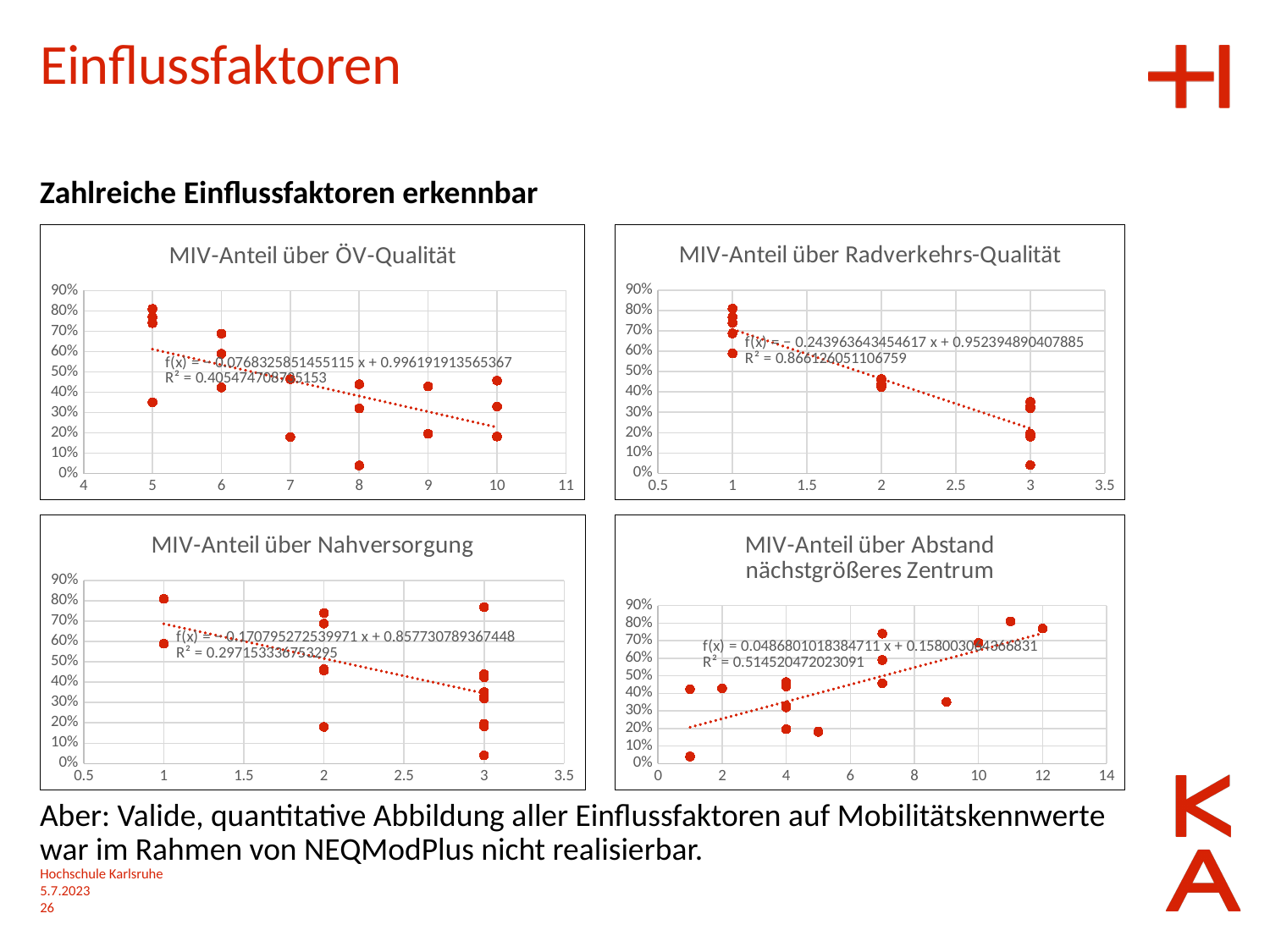
In the chart "MIV-Anteil über Radverkehrs-Qualität", what R² value is printed? 0.866126051106759 What kind of chart is "MIV-Anteil über ÖV-Qualität"? scatter chart In the chart "MIV-Anteil über Abstand nächstgrößeres Zentrum", does the dotted trendline rise or fall as the x value increases? rise In the chart "MIV-Anteil über Nahversorgung", does the dotted trendline rise or fall as the x value increases? fall What is the title of the top-left chart on the slide? MIV-Anteil über ÖV-Qualität In the chart "MIV-Anteil über ÖV-Qualität", does the dotted trendline rise or fall as the x value increases? fall In the chart "MIV-Anteil über Nahversorgung", is the higher of the two points at x = 1 greater or less than 70%? greater In the chart "MIV-Anteil über Radverkehrs-Qualität", are the points at x = 1 greater or less than 50%? greater How many charts are shown on the slide? 4 In the chart "MIV-Anteil über Radverkehrs-Qualität", is the lowest point at x = 3 greater or less than 10%? less In the chart "MIV-Anteil über Abstand nächstgrößeres Zentrum", what R² value is printed? 0.514520472023091